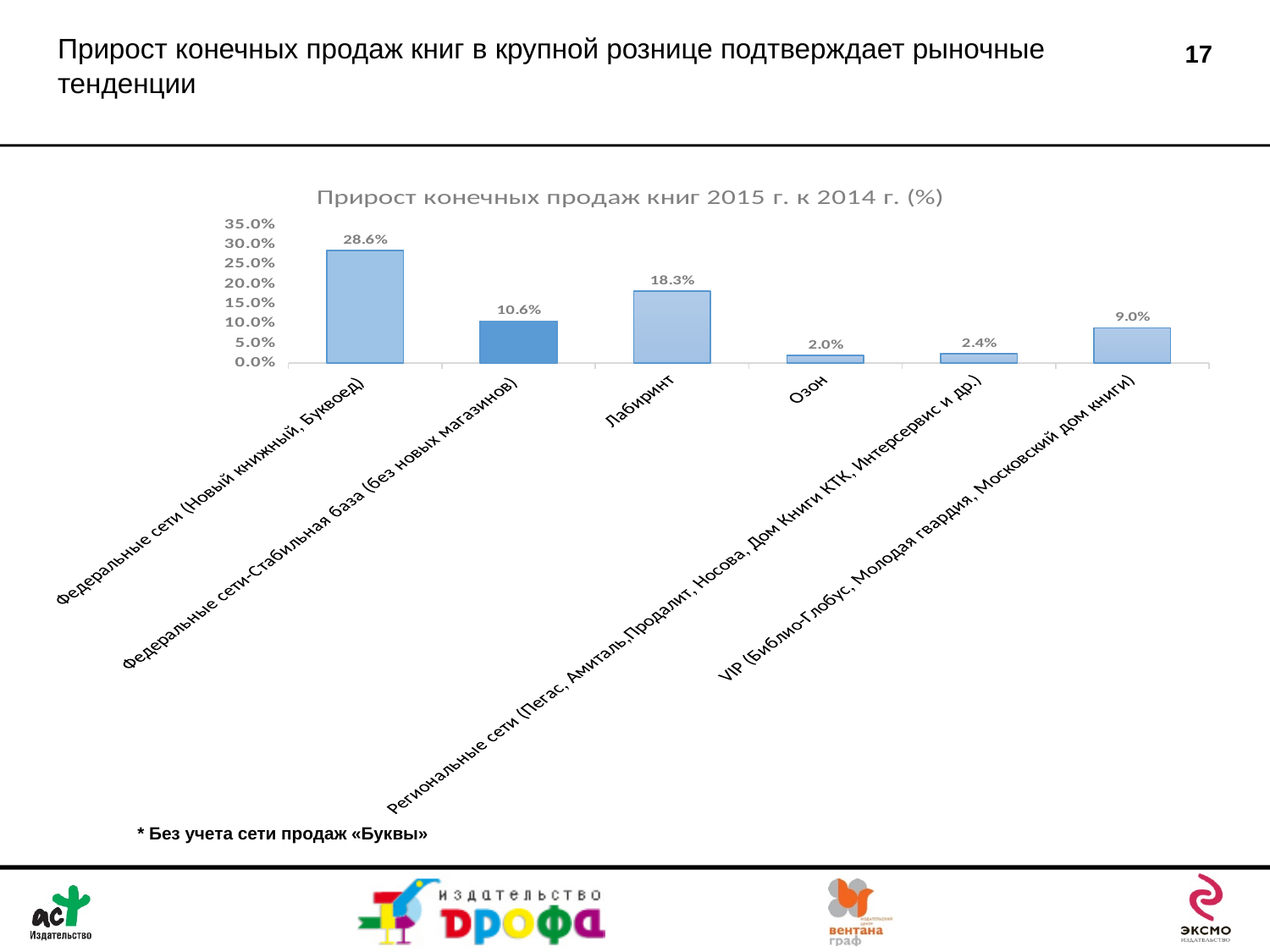
What is the difference between the values for Федеральные сети (Новый книжный, Буквоед) and Лабиринт? 10.3% Which is larger, the value for Региональные сети or the value for VIP? VIP How many categories are plotted in the chart? 6 Which category has the highest value? Федеральные сети (Новый книжный, Буквоед) What is the value for VIP (Библио-Глобус, Молодая гвардия, Московский дом книги)? 9.0% What is the value for Озон? 2.0% What type of chart is shown on the slide? bar chart Is the value for Федеральные сети (Новый книжный, Буквоед) greater or less than 25.0%? greater What is the title of the chart? Прирост конечных продаж книг 2015 г. к 2014 г. (%) What is the value for Лабиринт? 18.3% What is the value for Федеральные сети-Стабильная база (без новых магазинов)? 10.6% Which category has the lowest value? Озон